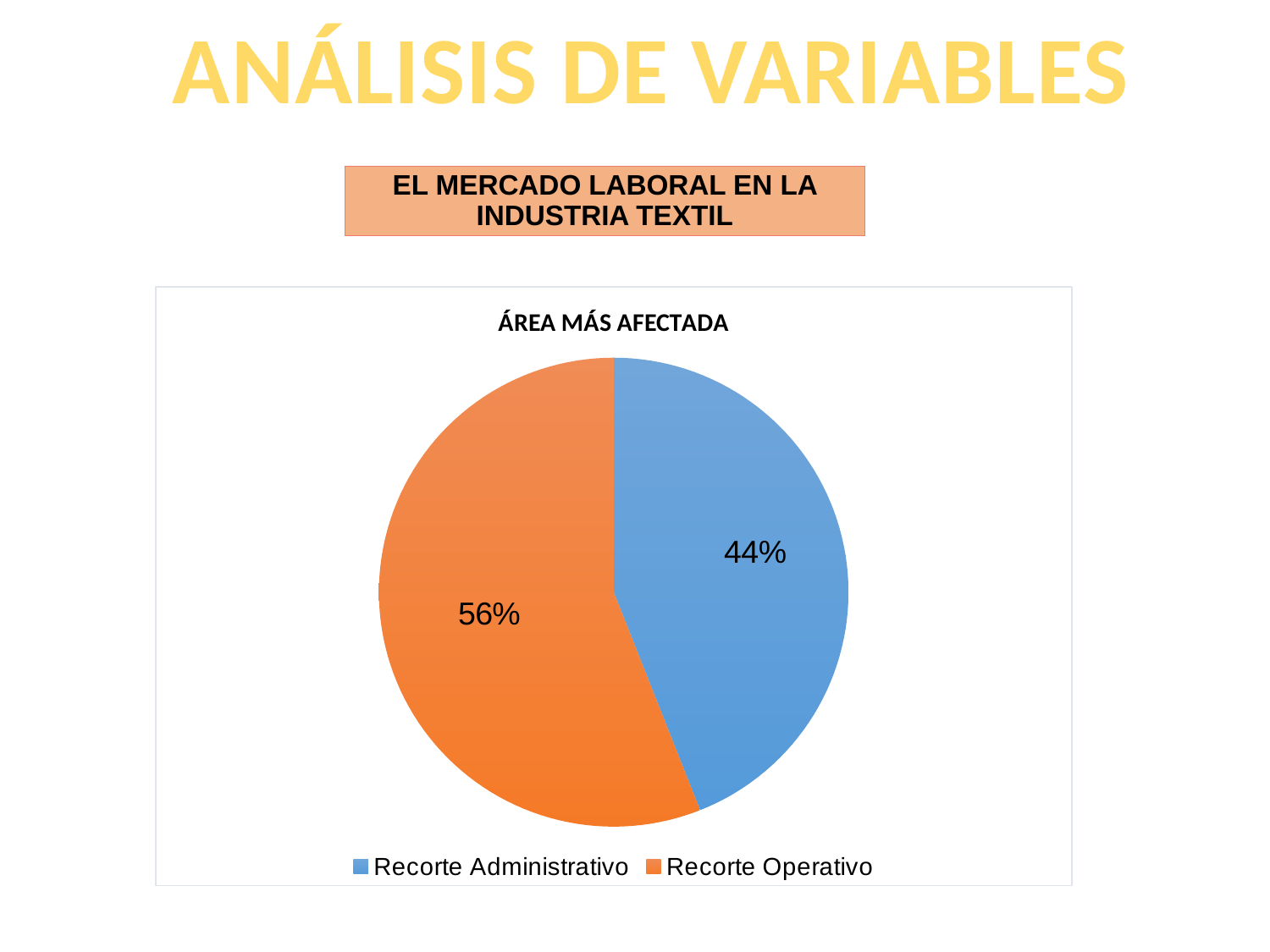
What colour is the slice for Recorte Operativo? orange Which is larger, the slice for Recorte Administrativo or the slice for Recorte Operativo? Recorte Operativo What kind of chart is shown on the slide? pie chart How many entries does the legend list? 2 How many slices does the pie chart have? 2 What is the difference in percentage points between Recorte Operativo and Recorte Administrativo? 12 What share of the pie does Recorte Operativo represent? 56% What share of the pie does Recorte Administrativo represent? 44% Which category has the largest slice of the pie? Recorte Operativo What is the title of the chart? ÁREA MÁS AFECTADA Which category has the smallest slice of the pie? Recorte Administrativo